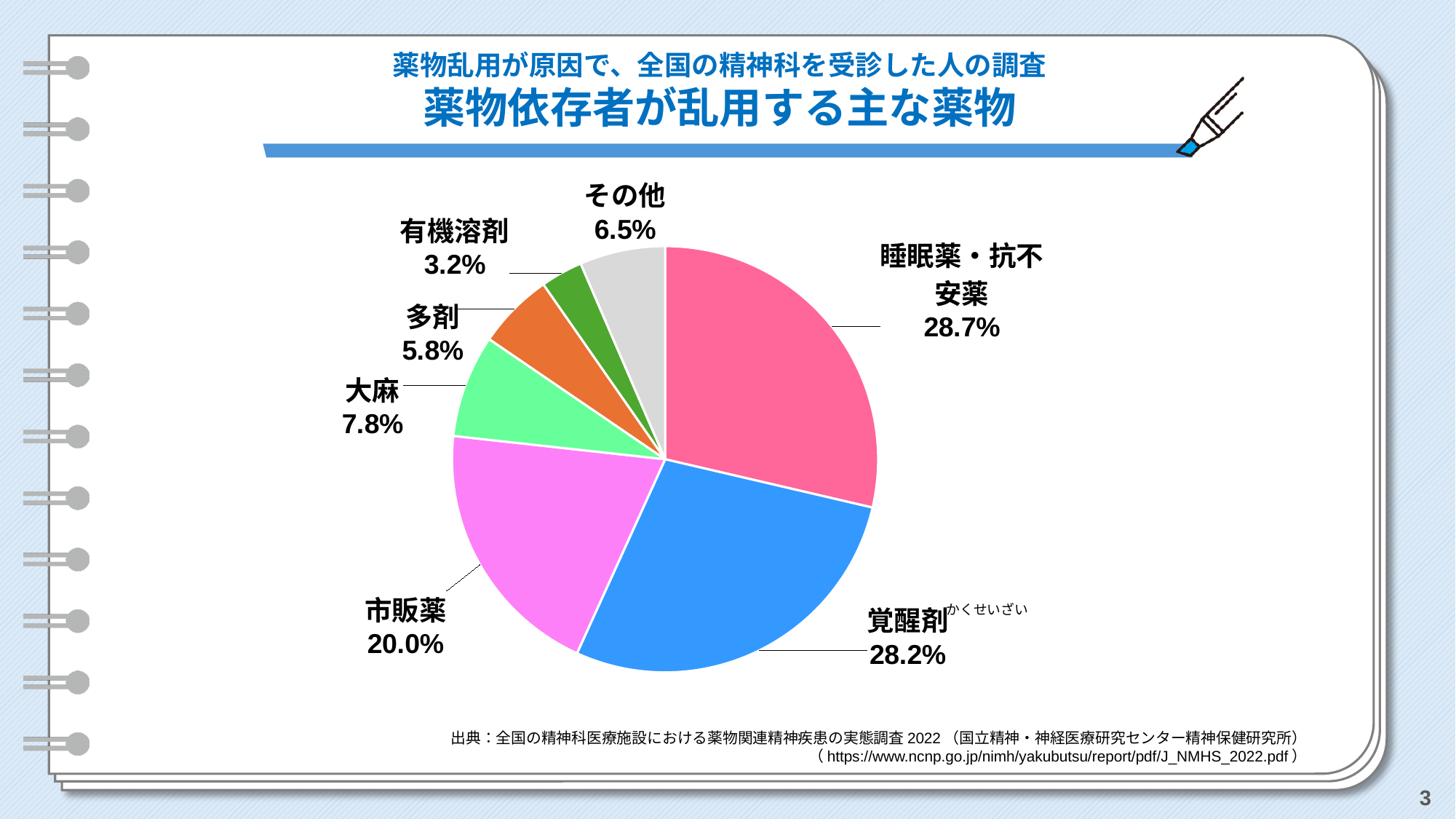
Which category has the largest share of the pie? 睡眠薬・抗不安薬 What percentage is shown for その他? 6.5% What is the share of the pie for 有機溶剤? 3.2% Which is larger, the share for 多剤 or the share for 大麻? 大麻 What is the difference in percentage points between 睡眠薬・抗不安薬 and 覚醒剤? 0.5 What type of chart is shown on the slide? pie chart What percentage is shown for 覚醒剤? 28.2% What percentage is shown for 市販薬? 20.0% How many slices does the pie chart have? 7 Which category has the smallest share of the pie? 有機溶剤 What percentage is shown for 大麻? 7.8% What is the title of the chart on the slide? 薬物依存者が乱用する主な薬物